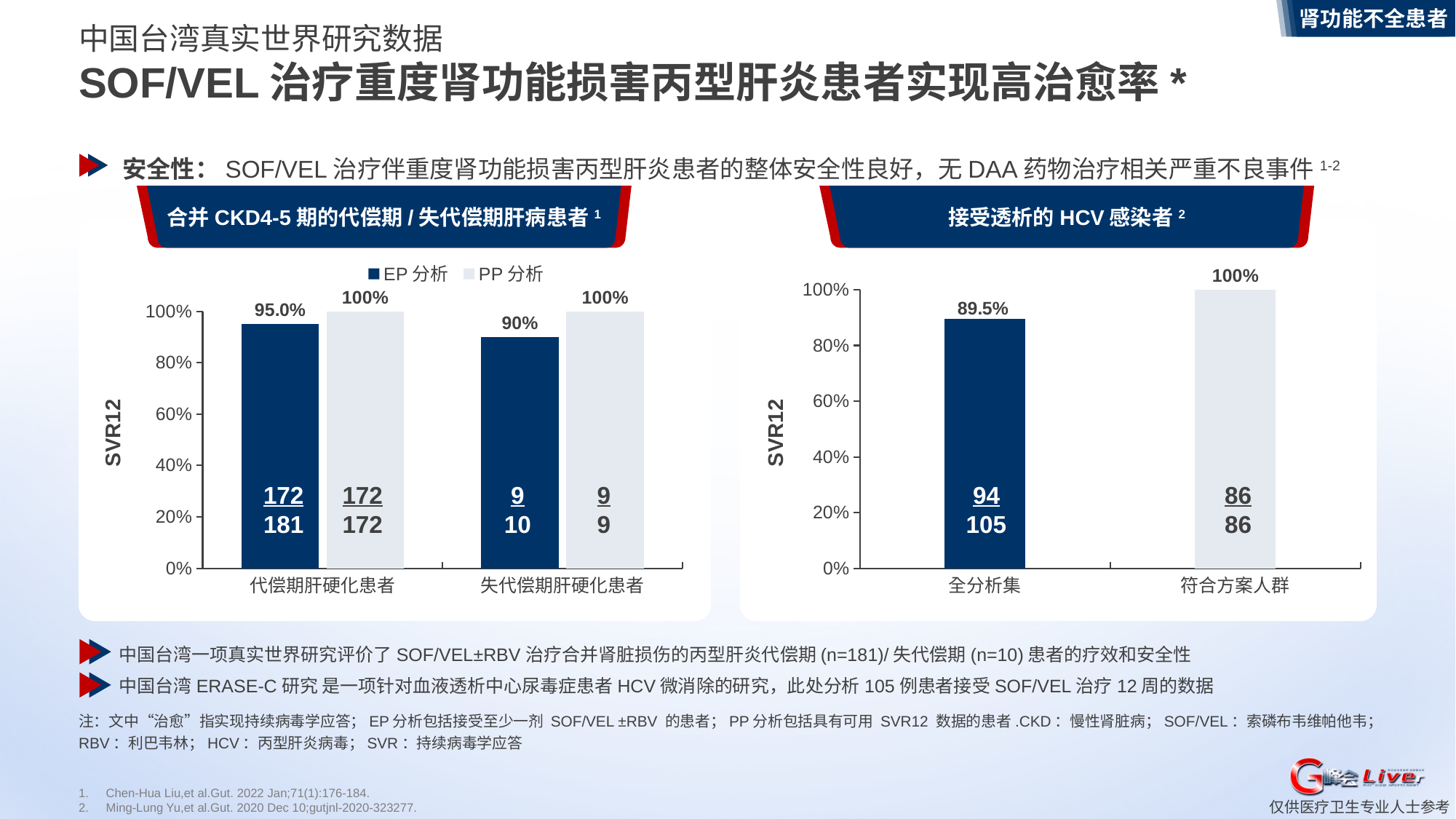
In the left chart (合并 CKD4-5 期的代偿期 / 失代偿期肝病患者), what is the SVR12 value for the PP 分析 series in the 失代偿期肝硬化患者 group? 100% What kind of chart is the right chart (接受透析的 HCV 感染者)? Bar chart In the right chart (接受透析的 HCV 感染者), what is the SVR12 value for 全分析集? 89.5% In the left chart (合并 CKD4-5 期的代偿期 / 失代偿期肝病患者), which EP 分析 value is larger: 代偿期肝硬化患者 or 失代偿期肝硬化患者? 代偿期肝硬化患者 In the left chart (合并 CKD4-5 期的代偿期 / 失代偿期肝病患者), what is the SVR12 value for the EP 分析 series in the 代偿期肝硬化患者 group? 95.0% In the left chart (合并 CKD4-5 期的代偿期 / 失代偿期肝病患者), what fraction is printed inside the EP 分析 bar for 代偿期肝硬化患者? 172/181 In the right chart (接受透析的 HCV 感染者), which category has the lowest SVR12 value? 全分析集 In the right chart (接受透析的 HCV 感染者), what is the SVR12 value for 符合方案人群? 100% In the left chart (合并 CKD4-5 期的代偿期 / 失代偿期肝病患者), what is the SVR12 value for the EP 分析 series in the 失代偿期肝硬化患者 group? 90% In the left chart (合并 CKD4-5 期的代偿期 / 失代偿期肝病患者), how many series does the legend list? 2 In the right chart (接受透析的 HCV 感染者), how many categories are shown on the x axis? 2 In the left chart (合并 CKD4-5 期的代偿期 / 失代偿期肝病患者), what is the difference between the PP 分析 and EP 分析 values for 代偿期肝硬化患者? 5.0%